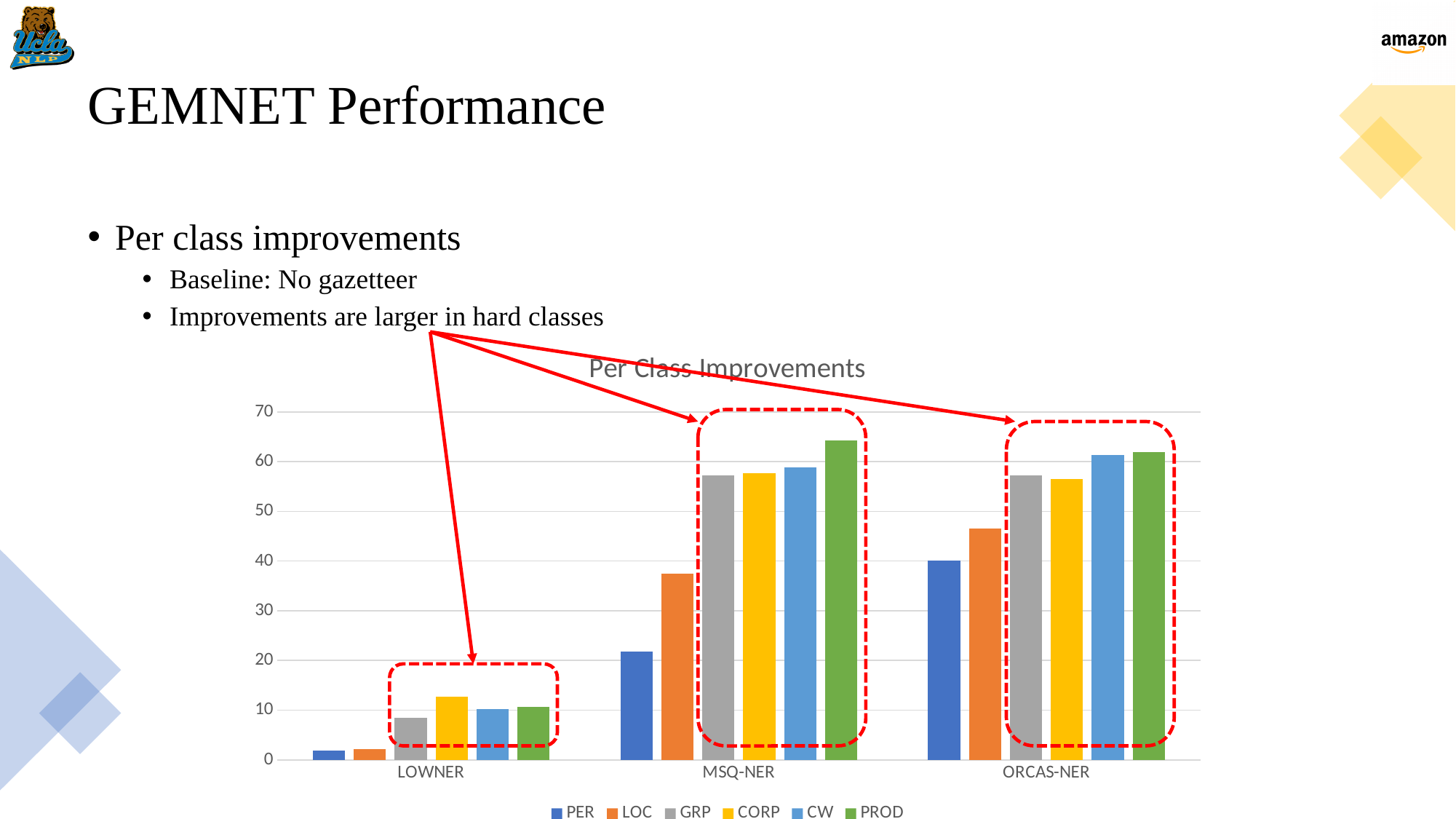
Do the PER values rise or fall moving from LOWNER to MSQ-NER to ORCAS-NER? rise What is the title of the chart? Per Class Improvements How many dataset categories are shown on the x axis of the chart? 3 Which class has the lowest value for ORCAS-NER? PER Which is larger, the LOC value for MSQ-NER or the LOC value for ORCAS-NER? ORCAS-NER What kind of chart is shown on the slide? bar chart Is the value for LOC in ORCAS-NER greater or less than 50? less Is the value for CORP in LOWNER greater or less than 10? greater Which class has the lowest value for MSQ-NER? PER Is the value for PROD in MSQ-NER greater or less than 60? greater How many series does the legend of the Per Class Improvements chart list? 6 Which class has the highest value for MSQ-NER? PROD